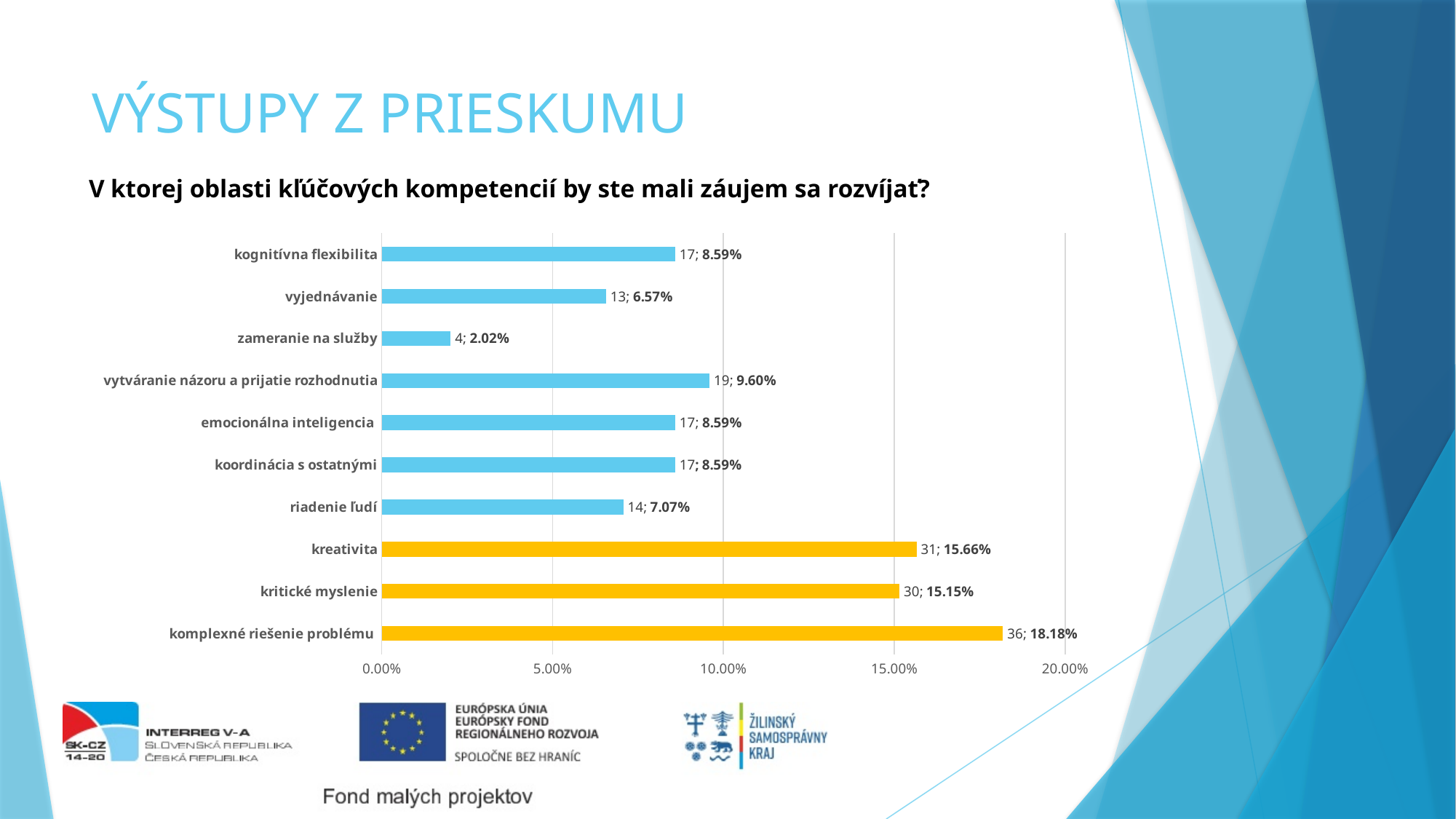
Which category has the lowest value? zameranie na služby What is the difference in count between komplexné riešenie problému and zameranie na služby? 32 What percentage is shown for vyjednávanie? 6.57% Which category has the highest value? komplexné riešenie problému What is the count shown for vytváranie názoru a prijatie rozhodnutia? 19 What is the difference in percentage between kreativita and kritické myslenie? 0.51% How many categories are shown in the chart? 10 How many respondents chose komplexné riešenie problému? 36 Which is larger, the value for kreativita or for kritické myslenie? kreativita Is the value for riadenie ľudí greater or less than 10.00%? less What kind of chart is shown on the slide? bar chart What percentage is shown for kreativita? 15.66%